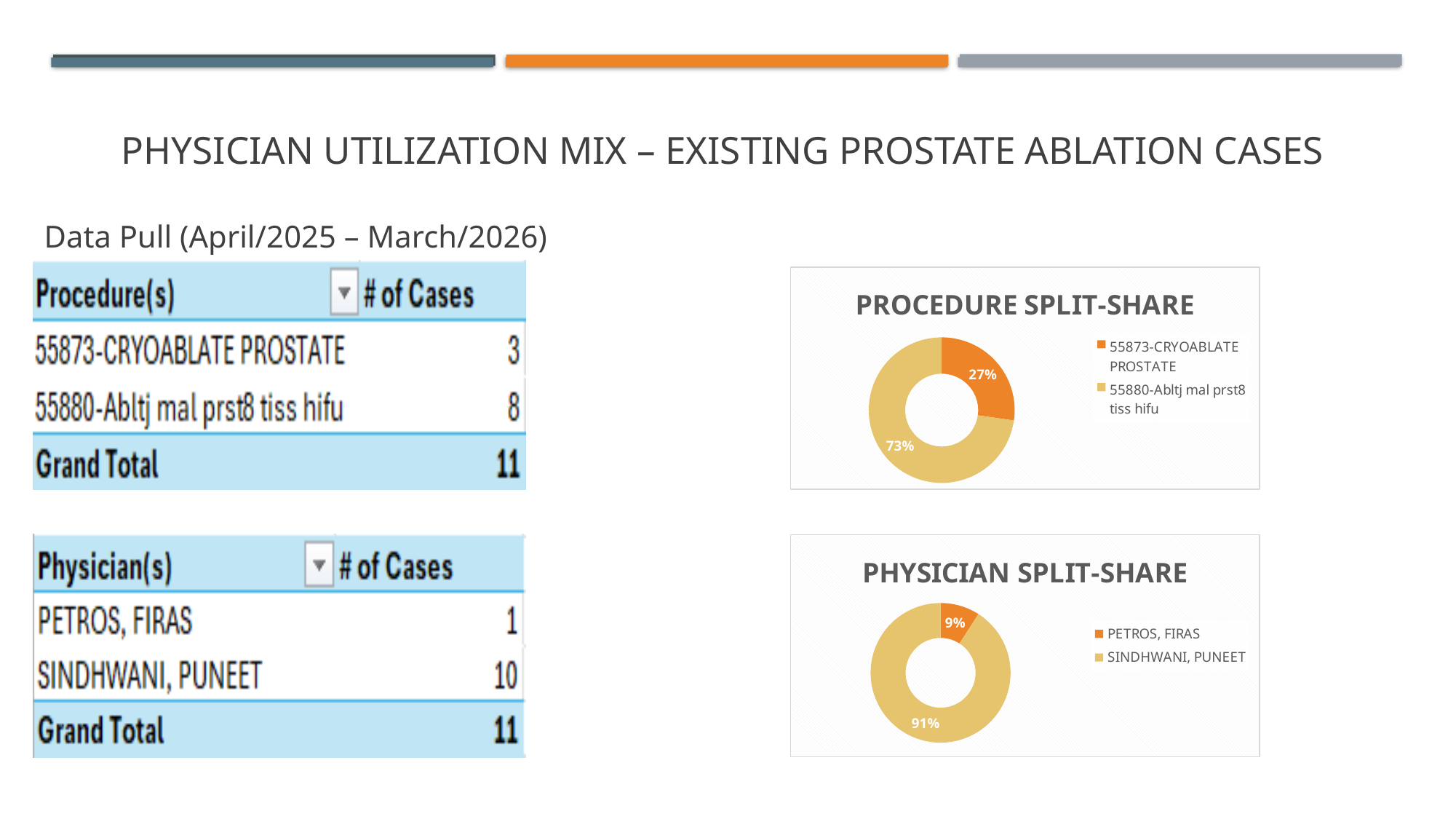
In the Physician Split-Share chart, what is the difference in percentage points between SINDHWANI, PUNEET and PETROS, FIRAS? 82 In the Procedure Split-Share chart, what share does 55880-Abltj mal prst8 tiss hifu have? 73% In the Physician Split-Share chart, which physician has the largest share? SINDHWANI, PUNEET In the Procedure Split-Share chart, how many categories does the legend list? 2 What kind of chart is the Procedure Split-Share chart? Doughnut chart In the Procedure Split-Share chart, which procedure has the largest share? 55880-Abltj mal prst8 tiss hifu In the Procedure Split-Share chart, which procedure has the smallest share? 55873-CRYOABLATE PROSTATE In the Physician Split-Share chart, what colour is the slice for PETROS, FIRAS? Orange In the Procedure Split-Share chart, what share does 55873-CRYOABLATE PROSTATE have? 27% In the Physician Split-Share chart, what share does SINDHWANI, PUNEET have? 91% In the Physician Split-Share chart, how many physicians are shown? 2